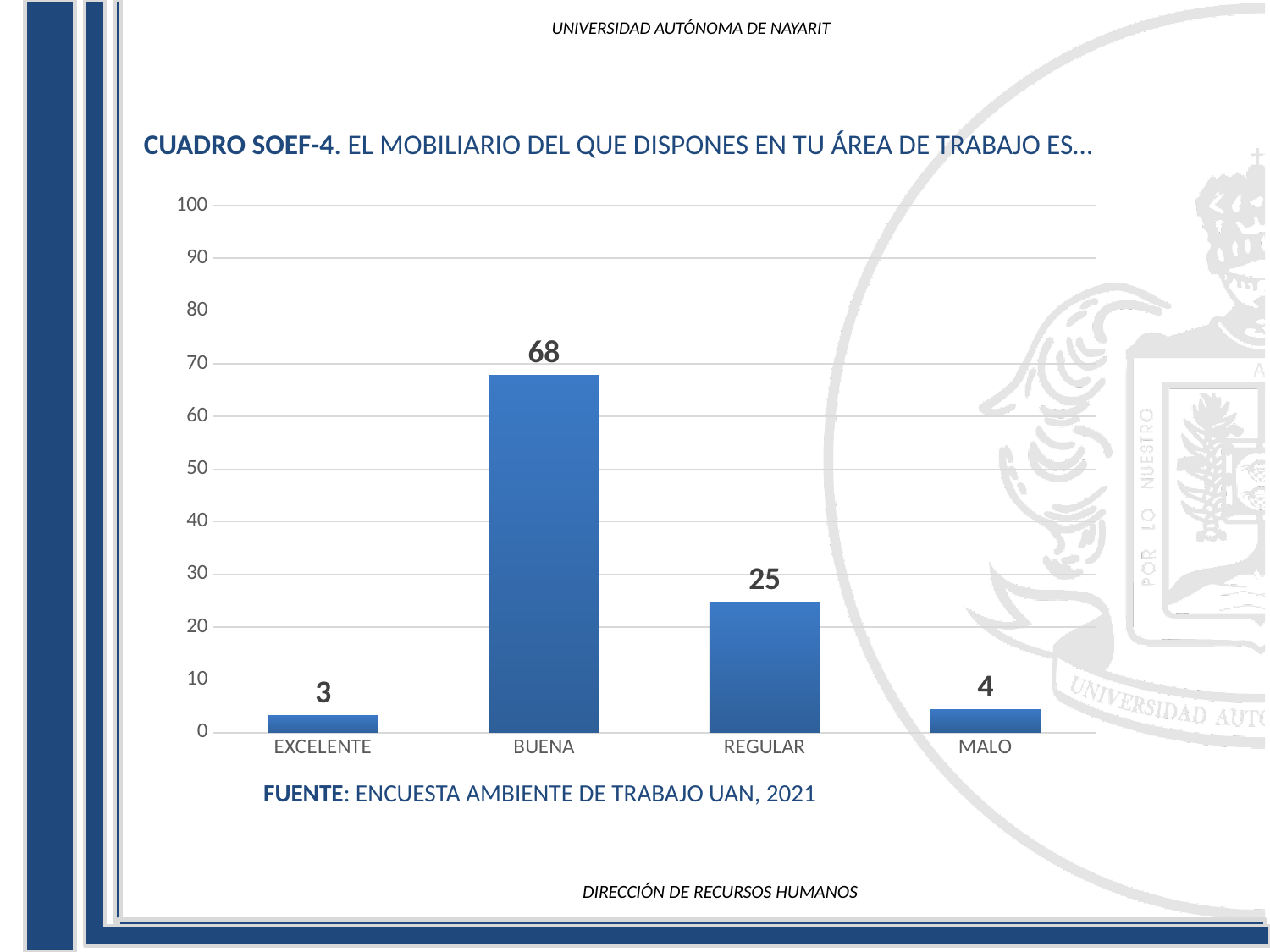
Is the value for REGULAR greater or less than 30? less What is the difference between the values for BUENA and REGULAR? 43 Which category has the highest value? BUENA What is the value for BUENA? 68 What is the value for MALO? 4 What is the value for EXCELENTE? 3 What is the value for REGULAR? 25 What kind of chart is shown on the slide? bar chart What source is cited below the chart? ENCUESTA AMBIENTE DE TRABAJO UAN, 2021 Which is larger, the value for MALO or the value for EXCELENTE? MALO Which category has the lowest value? EXCELENTE How many categories are shown on the x axis? 4